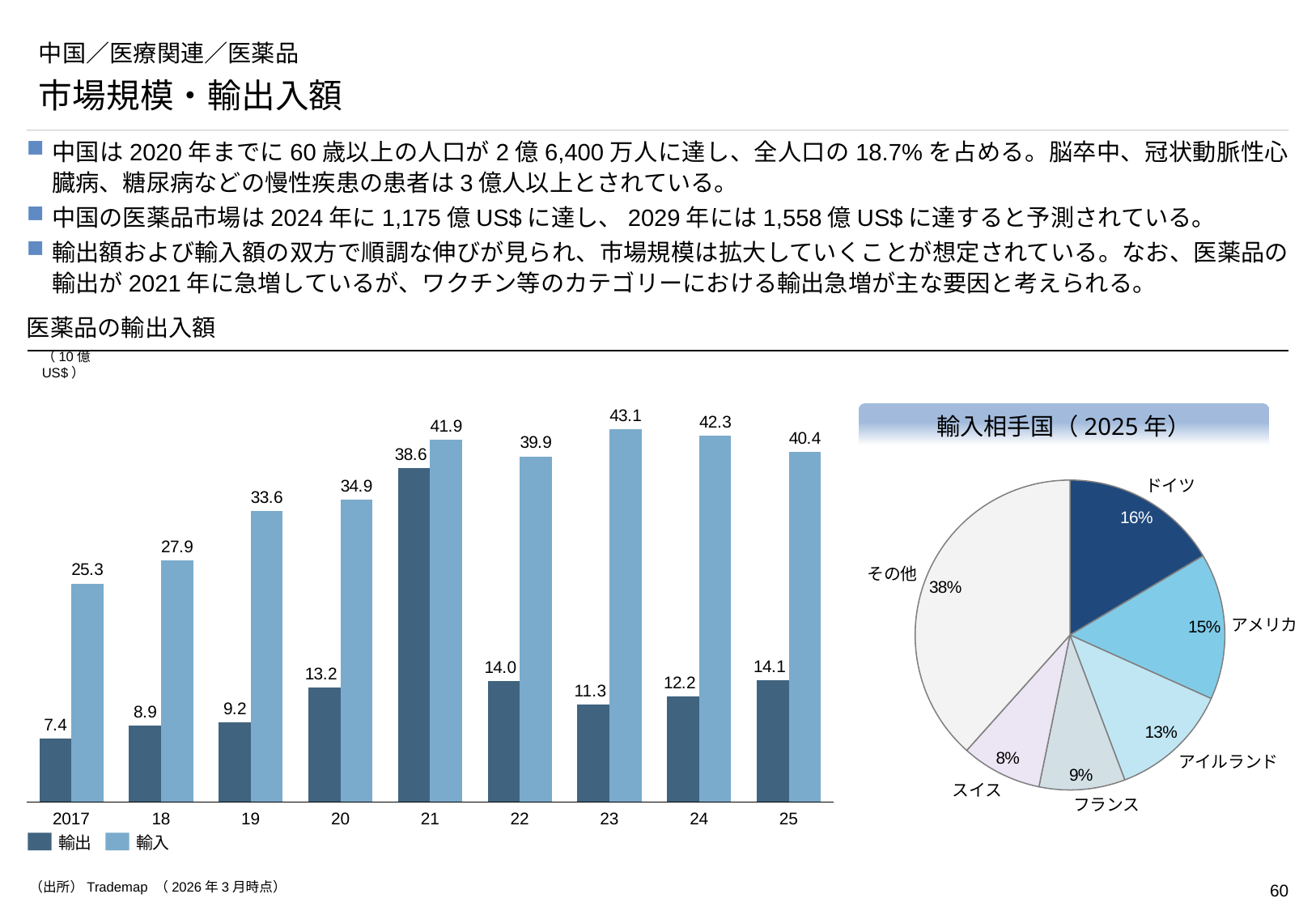
「医薬品の輸出入額」のグラフで、輸出が最も低い年はどれですか？ 2017 「医薬品の輸出入額」のグラフで、2021年の輸出の値はいくらですか？ 38.6 「輸入相手国（2025年）」の円グラフには何個の区分がありますか？ 6 「医薬品の輸出入額」のグラフで、2025年の輸入と輸出の差はいくらですか？ 26.3 「医薬品の輸出入額」のグラフの凡例には何系列ありますか？ 2 「医薬品の輸出入額」のグラフには何年分のデータがありますか？ 9 「医薬品の輸出入額」のグラフで、輸入が最も高い年はどれですか？ 23 「輸入相手国（2025年）」の円グラフで、最も割合が小さい国はどこですか？ スイス 「輸入相手国（2025年）」の円グラフで、ドイツの割合はいくらですか？ 16% 「医薬品の輸出入額」のグラフで、2022年の輸出と2023年の輸出ではどちらが大きいですか？ 2022年の輸出 「医薬品の輸出入額」のグラフはどの種類のグラフですか？ 棒グラフ 「医薬品の輸出入額」のグラフで、2017年の輸入の値はいくらですか？ 25.3